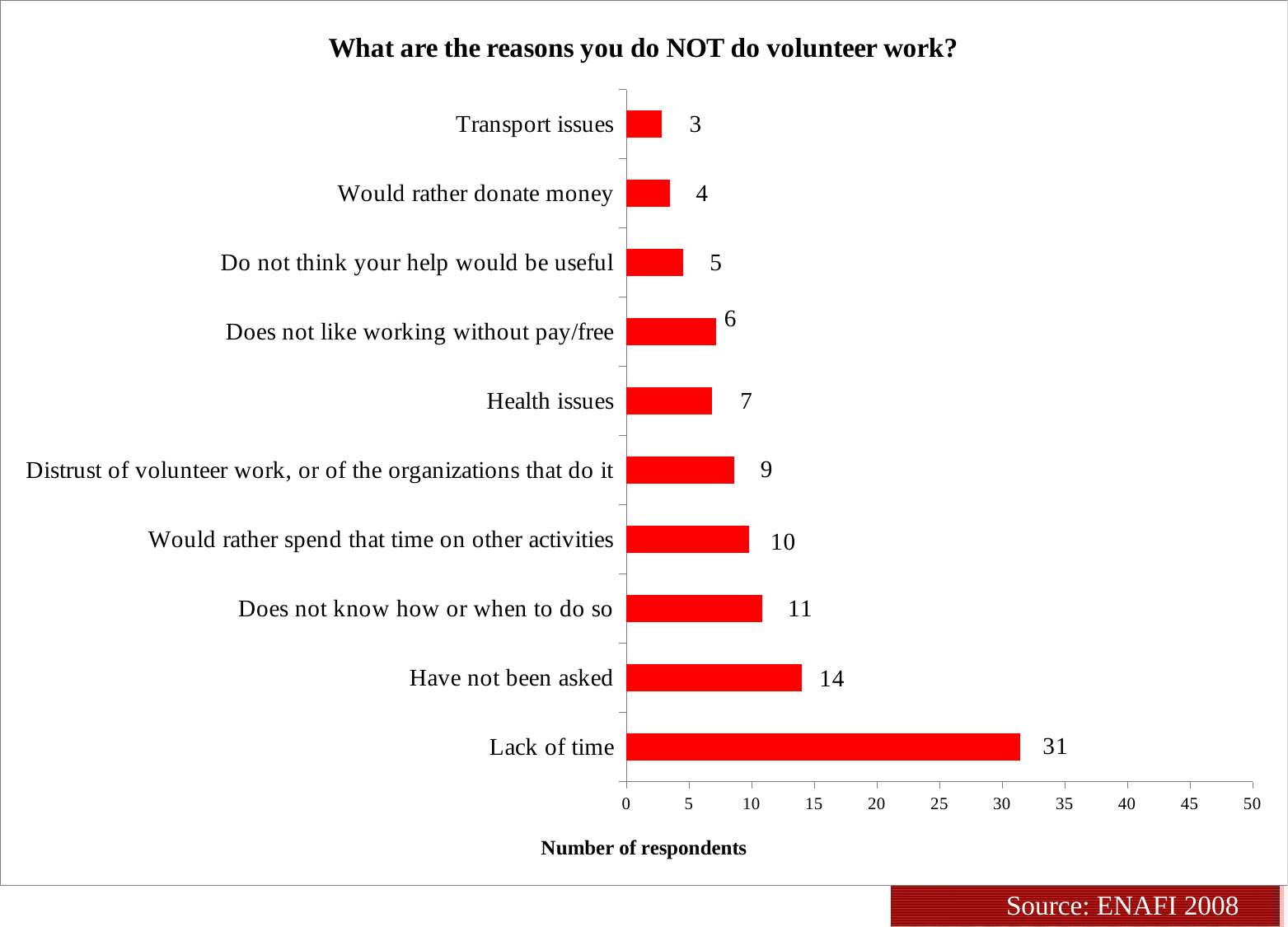
What is the title of the chart? What are the reasons you do NOT do volunteer work? What is the number of respondents for "Would rather donate money"? 4 What is the label of the horizontal axis? Number of respondents What is the number of respondents for "Health issues"? 7 Which reason has the lowest number of respondents? Transport issues What is the difference in respondents between "Lack of time" and "Have not been asked"? 17 Is the value for "Lack of time" greater or less than 30? greater How many reasons are shown in the chart? 10 Which has more respondents: "Does not know how or when to do so" or "Distrust of volunteer work, or of the organizations that do it"? Does not know how or when to do so Which reason has the highest number of respondents? Lack of time What is the number of respondents for "Lack of time"? 31 What kind of chart is shown on the slide? Bar chart